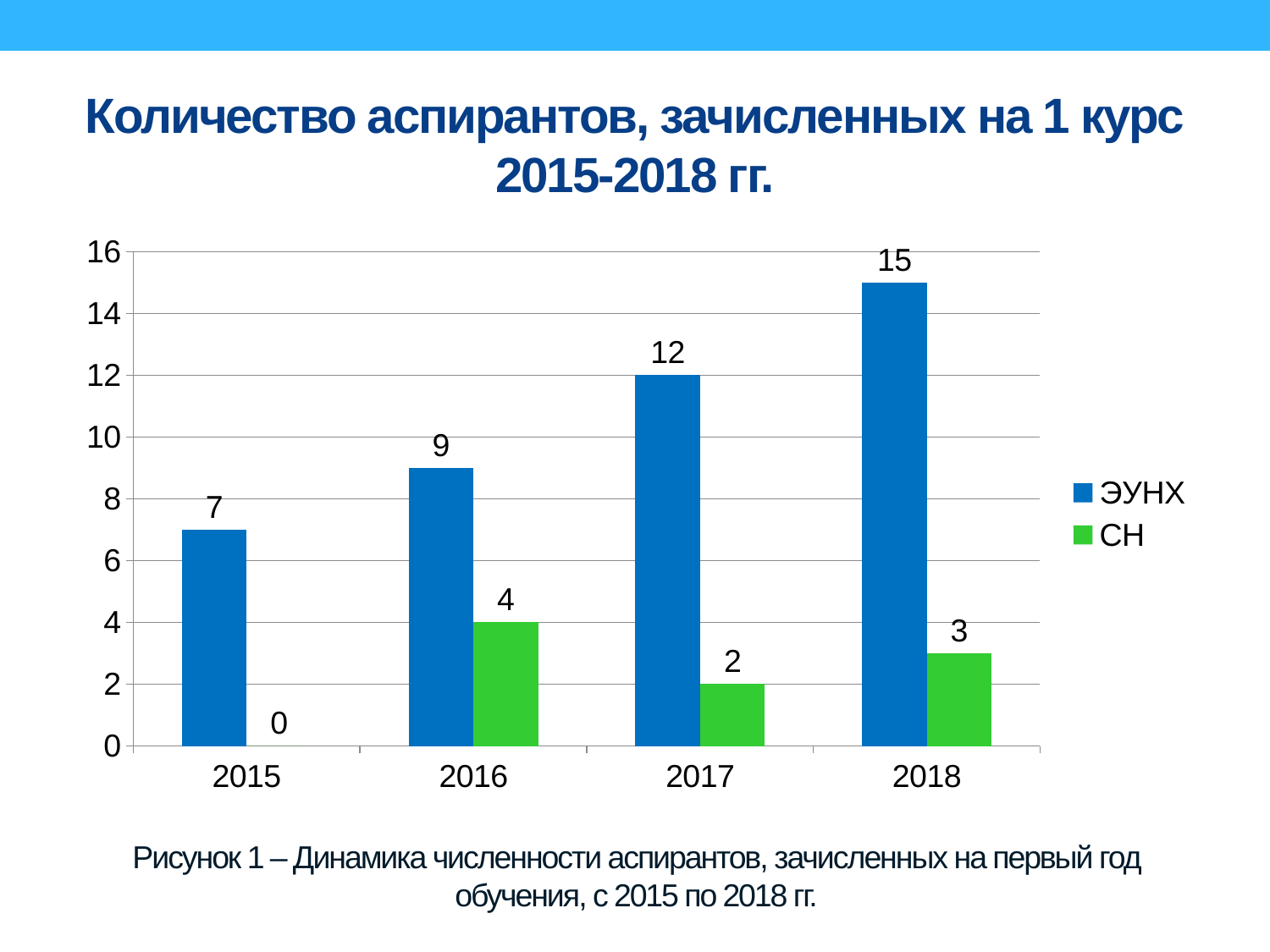
What is the value for СН in 2016? 4 What is the difference between the ЭУНХ and СН values in 2018? 12 How many series does the legend list? 2 In which year is the ЭУНХ value highest? 2018 Which is larger: the ЭУНХ value in 2016 or the ЭУНХ value in 2015? ЭУНХ in 2016 What kind of chart is shown on the slide? bar chart What is the value for ЭУНХ in 2017? 12 In which year is the СН value lowest? 2015 Do the ЭУНХ values rise or fall from 2015 to 2018? rise How many years are shown on the x axis? 4 Is the ЭУНХ value for 2018 greater or less than 14? greater What is the value for СН in 2015? 0